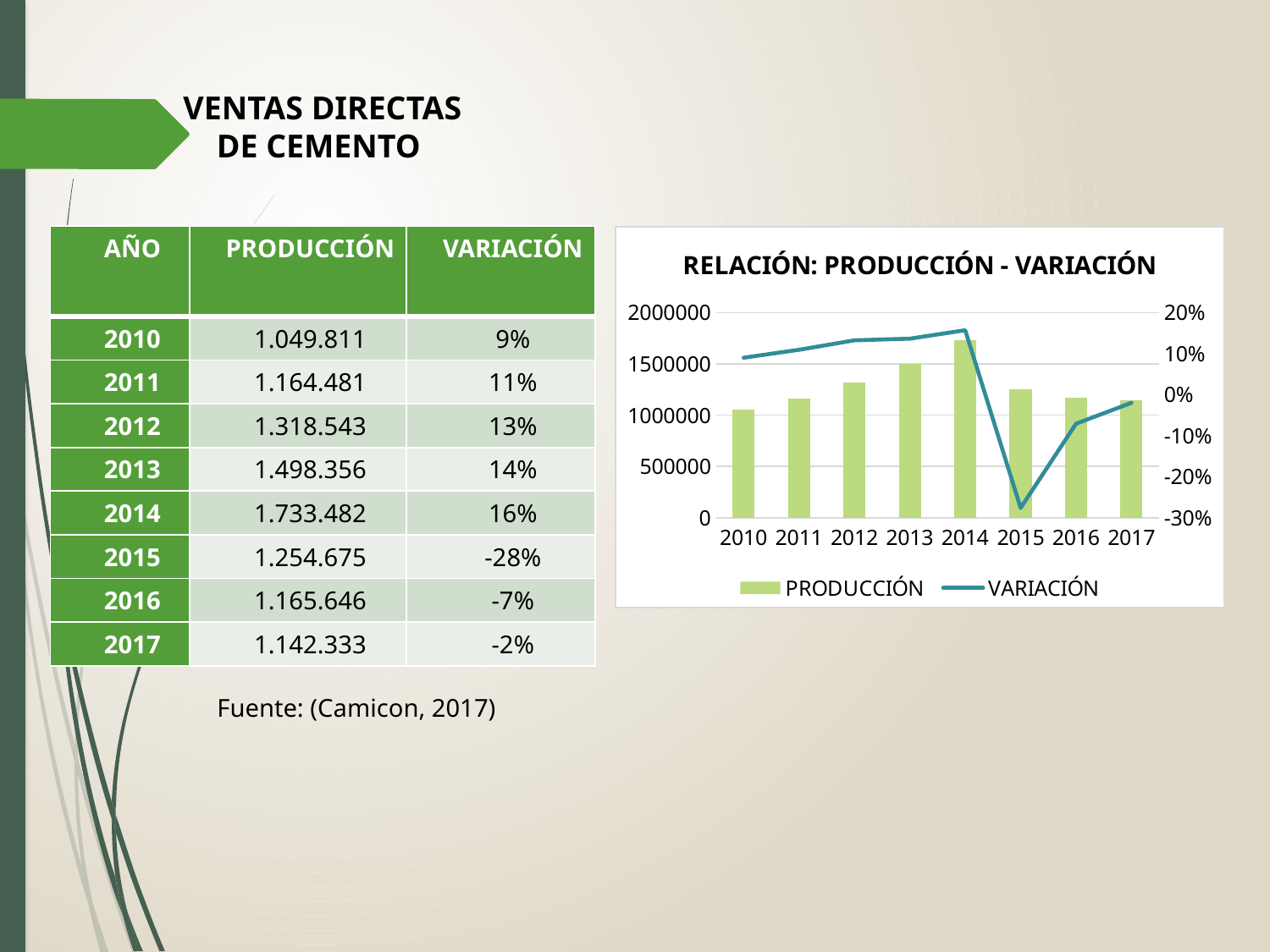
How many series does the legend of the chart list? 2 Which year has the larger PRODUCCIÓN bar, 2013 or 2016? 2013 In which year is the PRODUCCIÓN bar the highest? 2014 What is the PRODUCCIÓN value for 2014 as printed on the slide? 1.733.482 What kind of chart is shown under the title RELACIÓN: PRODUCCIÓN - VARIACIÓN? A combined bar and line chart Is the PRODUCCIÓN value for 2014 greater or less than 1500000? greater In which year does the VARIACIÓN line reach its lowest point? 2015 Is the VARIACIÓN value for 2015 greater or less than -20%? less How does PRODUCCIÓN change from 2010 to 2014 in the chart? It rises In which year is the PRODUCCIÓN bar the lowest? 2010 Which series is drawn as a line in the chart? VARIACIÓN How many years are shown on the x axis of the chart? 8